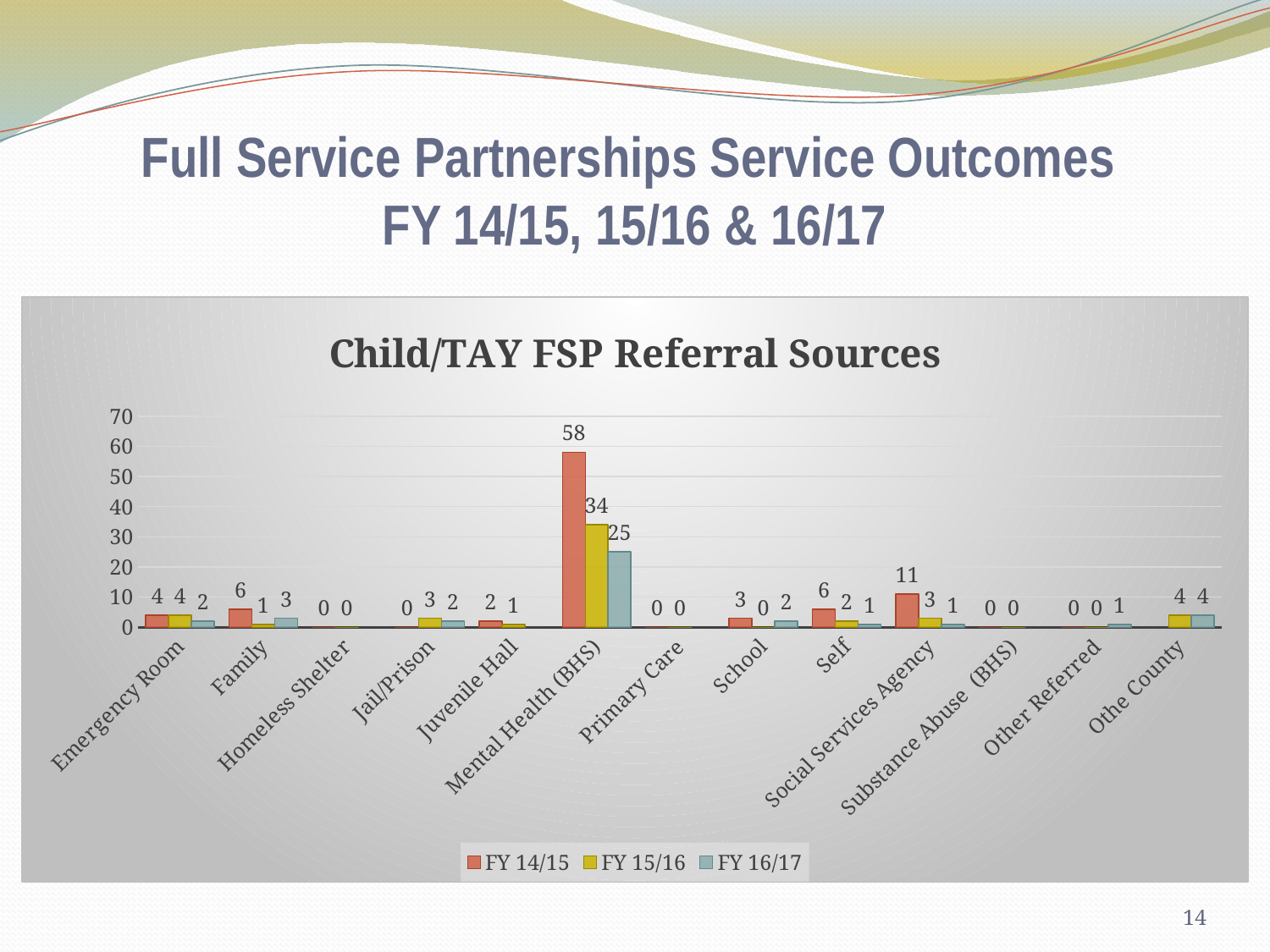
Is the FY 14/15 value for Mental Health (BHS) greater or less than 50? greater How many referral source categories are shown on the x axis? 13 How many series does the legend list? 3 What is the difference between the FY 14/15 and FY 15/16 values for Mental Health (BHS)? 24 What kind of chart is shown? bar chart Which referral source has the highest FY 14/15 value? Mental Health (BHS) What is the FY 16/17 value for Mental Health (BHS)? 25 What is the FY 14/15 value for Social Services Agency? 11 What is the FY 16/17 value for Emergency Room? 2 Which is larger for FY 14/15: Social Services Agency or Family? Social Services Agency Do the Mental Health (BHS) values rise or fall from FY 14/15 to FY 16/17? fall What is the FY 14/15 value for Mental Health (BHS)? 58